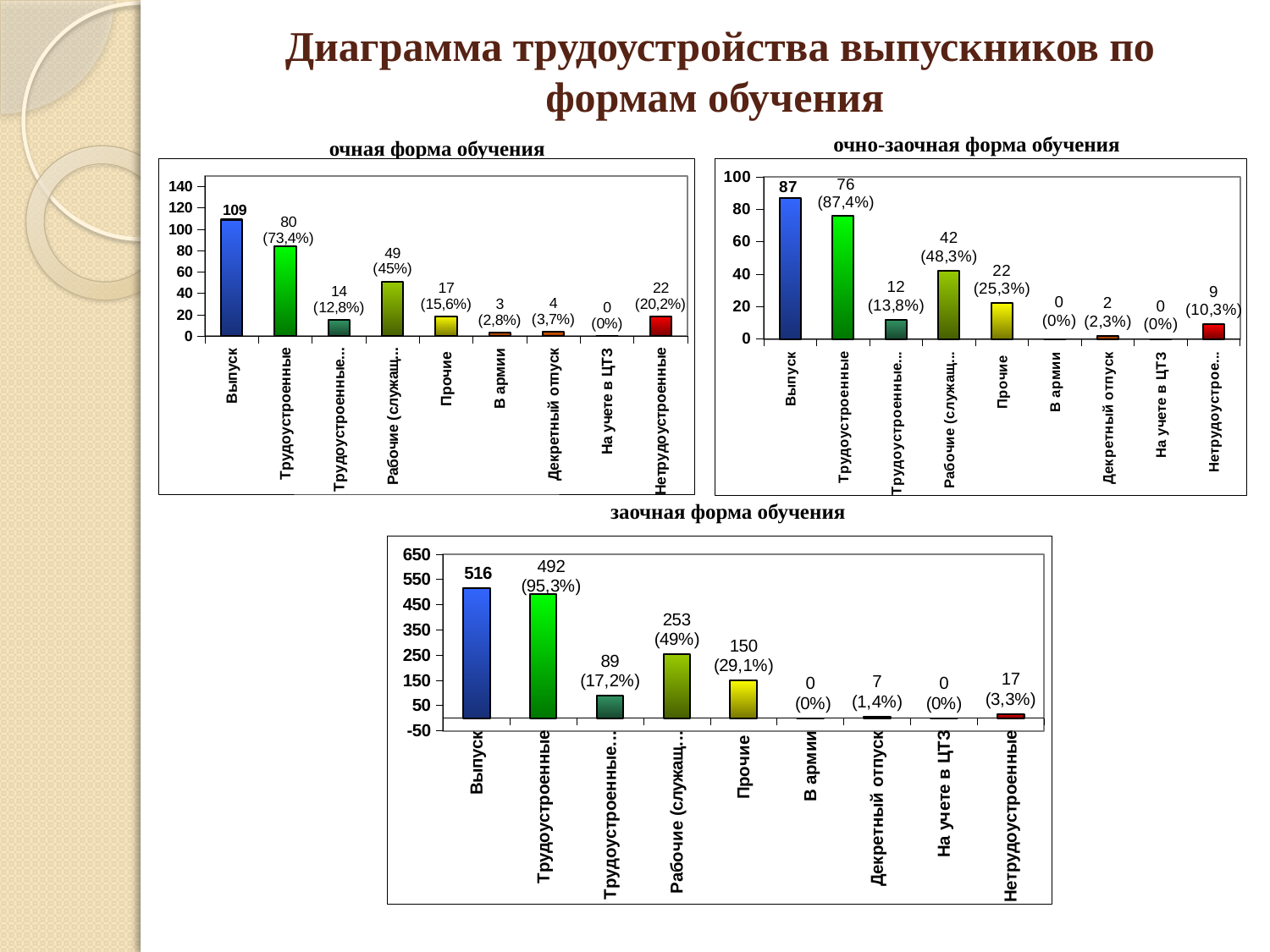
In the chart titled "очная форма обучения", what is the value for Выпуск? 109 In the chart titled "очная форма обучения", what is the difference between Выпуск and Трудоустроенные? 29 In the chart titled "очно-заочная форма обучения", which is larger, Рабочие (служащ... or Прочие? Рабочие (служащ... In the chart titled "очная форма обучения", what is the value for Нетрудоустроенные? 22 In the chart titled "очная форма обучения", what percentage is shown for Трудоустроенные? 73,4% In the chart titled "заочная форма обучения", what is the difference between Выпуск and Трудоустроенные? 24 What type of chart is the chart titled "очная форма обучения"? Bar chart How many categories are shown on the x axis of the chart titled "заочная форма обучения"? 9 In the chart titled "очно-заочная форма обучения", what is the value for Прочие? 22 In the chart titled "заочная форма обучения", what is the value for Трудоустроенные? 492 In the chart titled "очно-заочная форма обучения", which category has the highest value? Выпуск In the chart titled "заочная форма обучения", what percentage is shown for Рабочие (служащ...? 49%